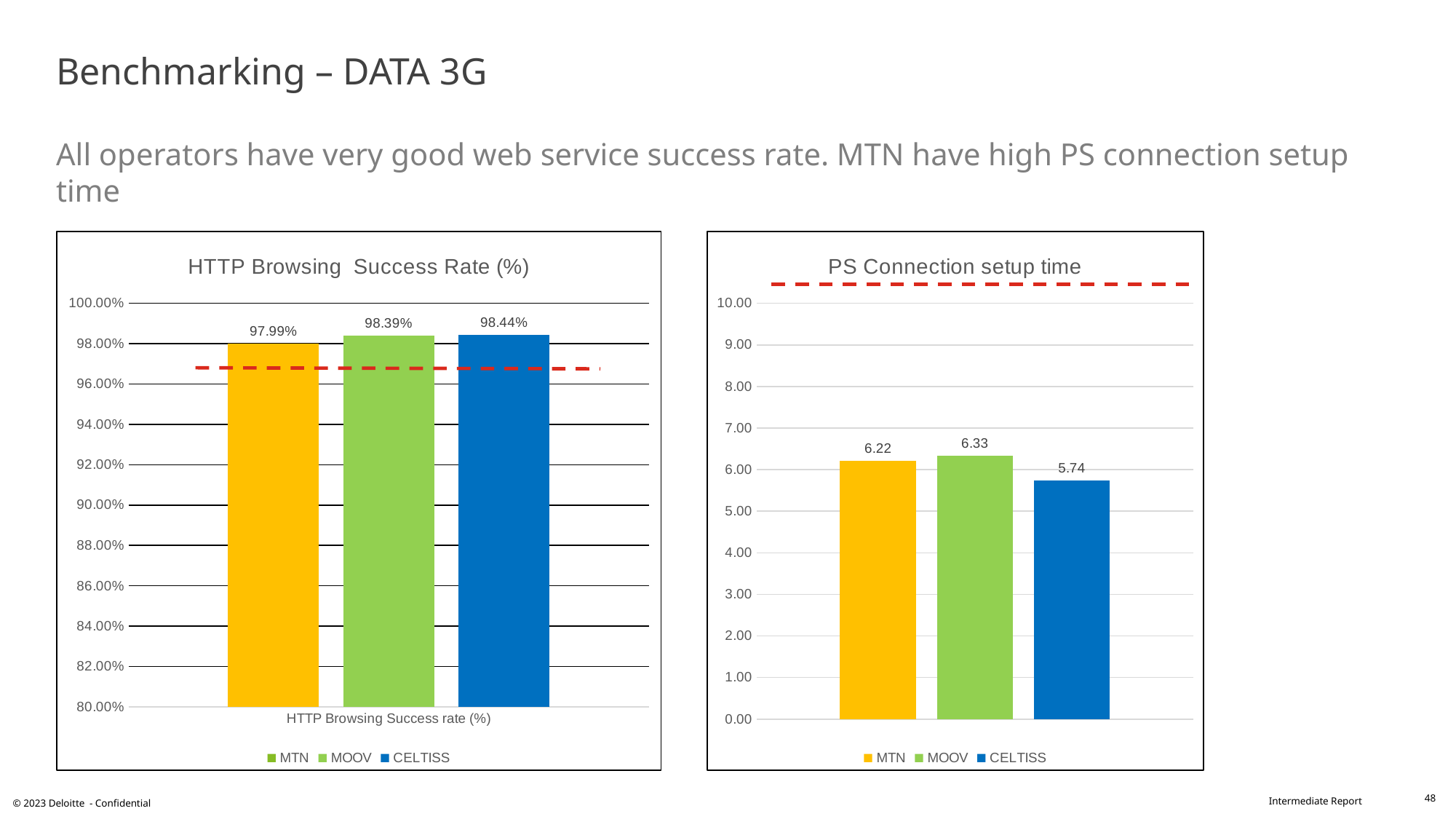
In the PS Connection setup time chart, which operator has the lowest setup time? CELTISS How many series does the legend of the PS Connection setup time chart list? 3 What kind of chart is the HTTP Browsing Success Rate (%) chart? bar chart In the PS Connection setup time chart, what is the value for CELTISS? 5.74 In the HTTP Browsing Success Rate (%) chart, which is larger, the value for MTN or the value for CELTISS? CELTISS In the PS Connection setup time chart, which operator has the highest setup time? MOOV In the HTTP Browsing Success Rate (%) chart, what is the value for CELTISS? 98.44% In the PS Connection setup time chart, is the value for MOOV greater or less than 6.00? greater In the PS Connection setup time chart, what is the difference between the MTN and CELTISS values? 0.48 In the HTTP Browsing Success Rate (%) chart, which operator has the lowest success rate? MTN In the HTTP Browsing Success Rate (%) chart, what is the value for MTN? 97.99% In the PS Connection setup time chart, what is the value for MOOV? 6.33